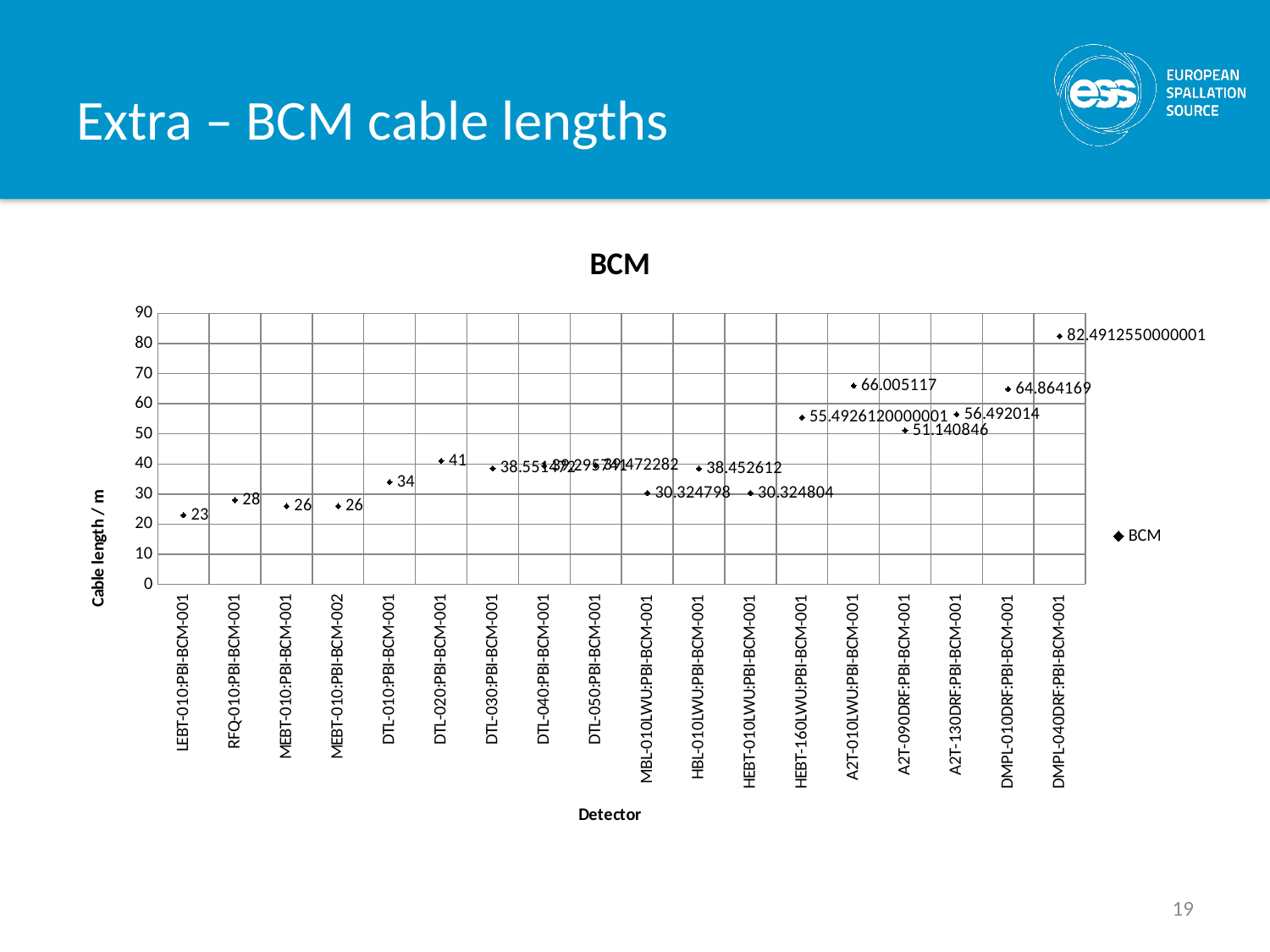
What is the cable length for A2T-090DRF:PBI-BCM-001? 51.140846 What is the cable length for A2T-010LWU:PBI-BCM-001? 66.005117 Which detector has the longest cable length? DMPL-040DRF:PBI-BCM-001 How many series does the legend list? 1 Which has a longer cable, DTL-010:PBI-BCM-001 or DMPL-010DRF:PBI-BCM-001? DMPL-010DRF:PBI-BCM-001 Is the cable length for HEBT-160LWU:PBI-BCM-001 greater or less than 50? greater What is the label of the y axis? Cable length / m What is the cable length for LEBT-010:PBI-BCM-001? 23 What is the cable length for DTL-020:PBI-BCM-001? 41 Which detector has the shortest cable length? LEBT-010:PBI-BCM-001 How many detectors are plotted on the chart? 18 What is the difference in cable length between RFQ-010:PBI-BCM-001 and LEBT-010:PBI-BCM-001? 5